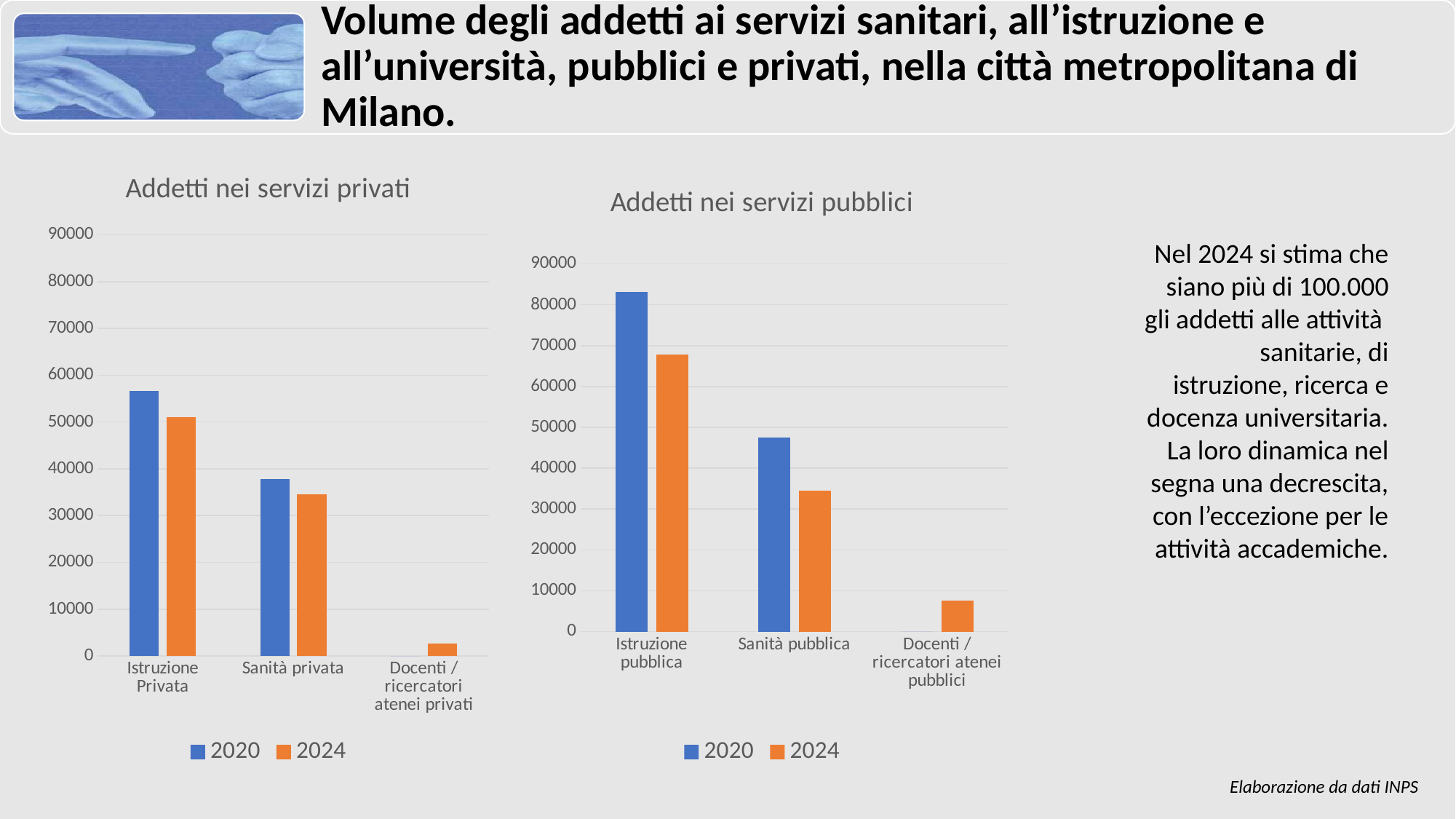
In the "Addetti nei servizi privati" chart, is the 2020 value for Istruzione Privata greater or less than 50000? greater In the "Addetti nei servizi pubblici" chart, how many series does the legend list? 2 In the "Addetti nei servizi pubblici" chart, is the 2024 value for Docenti / ricercatori atenei pubblici greater or less than 10000? less In the "Addetti nei servizi pubblici" chart, is the 2020 value for Istruzione pubblica greater or less than 80000? greater In the "Addetti nei servizi pubblici" chart, which year has the larger value for Sanità pubblica, 2020 or 2024? 2020 What are the two legend entries in the "Addetti nei servizi privati" chart? 2020 and 2024 What kind of chart is "Addetti nei servizi privati"? bar chart In the "Addetti nei servizi pubblici" chart, which category has the lowest value for 2024? Docenti / ricercatori atenei pubblici Which is larger: the 2024 value for Istruzione pubblica in the "Addetti nei servizi pubblici" chart or the 2024 value for Istruzione Privata in the "Addetti nei servizi privati" chart? Istruzione pubblica In the "Addetti nei servizi pubblici" chart, which category has the highest value for 2020? Istruzione pubblica How many categories are shown on the x axis of the "Addetti nei servizi privati" chart? 3